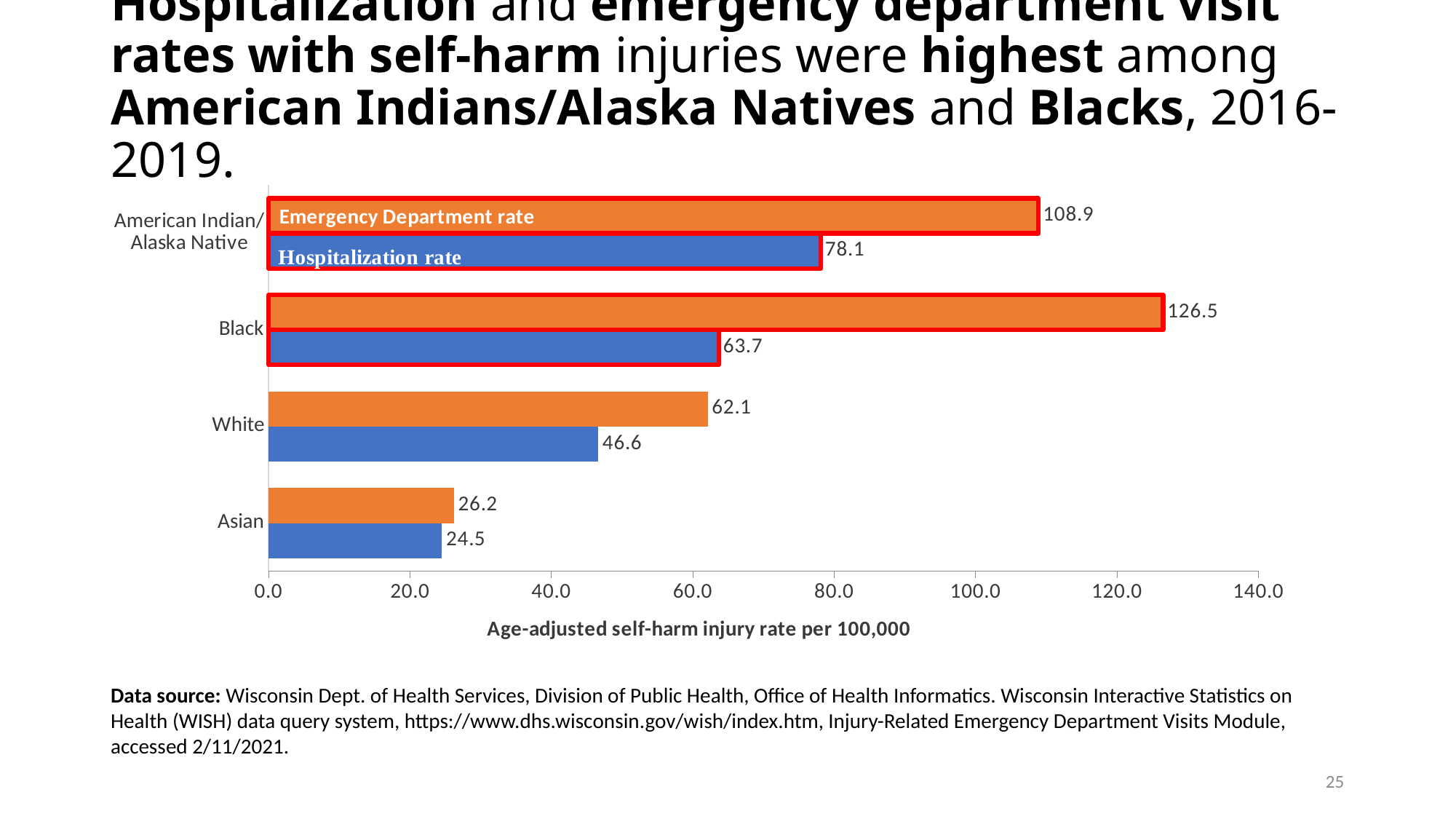
What is the Hospitalization rate for American Indian/Alaska Native? 78.1 What is the difference between the Emergency Department rate and the Hospitalization rate for White? 15.5 What is the label of the horizontal axis? Age-adjusted self-harm injury rate per 100,000 What is the Emergency Department rate for Asian? 26.2 How many series does the chart show? 2 What is the Emergency Department rate for Black? 126.5 What kind of chart is shown on the slide? Bar chart Which is larger: the Hospitalization rate for American Indian/Alaska Native or the Hospitalization rate for Black? American Indian/Alaska Native Is the Emergency Department rate for American Indian/Alaska Native greater or less than 100.0? greater Which racial group has the lowest Hospitalization rate? Asian How many racial groups are shown on the chart? 4 Which racial group has the highest Emergency Department rate? Black